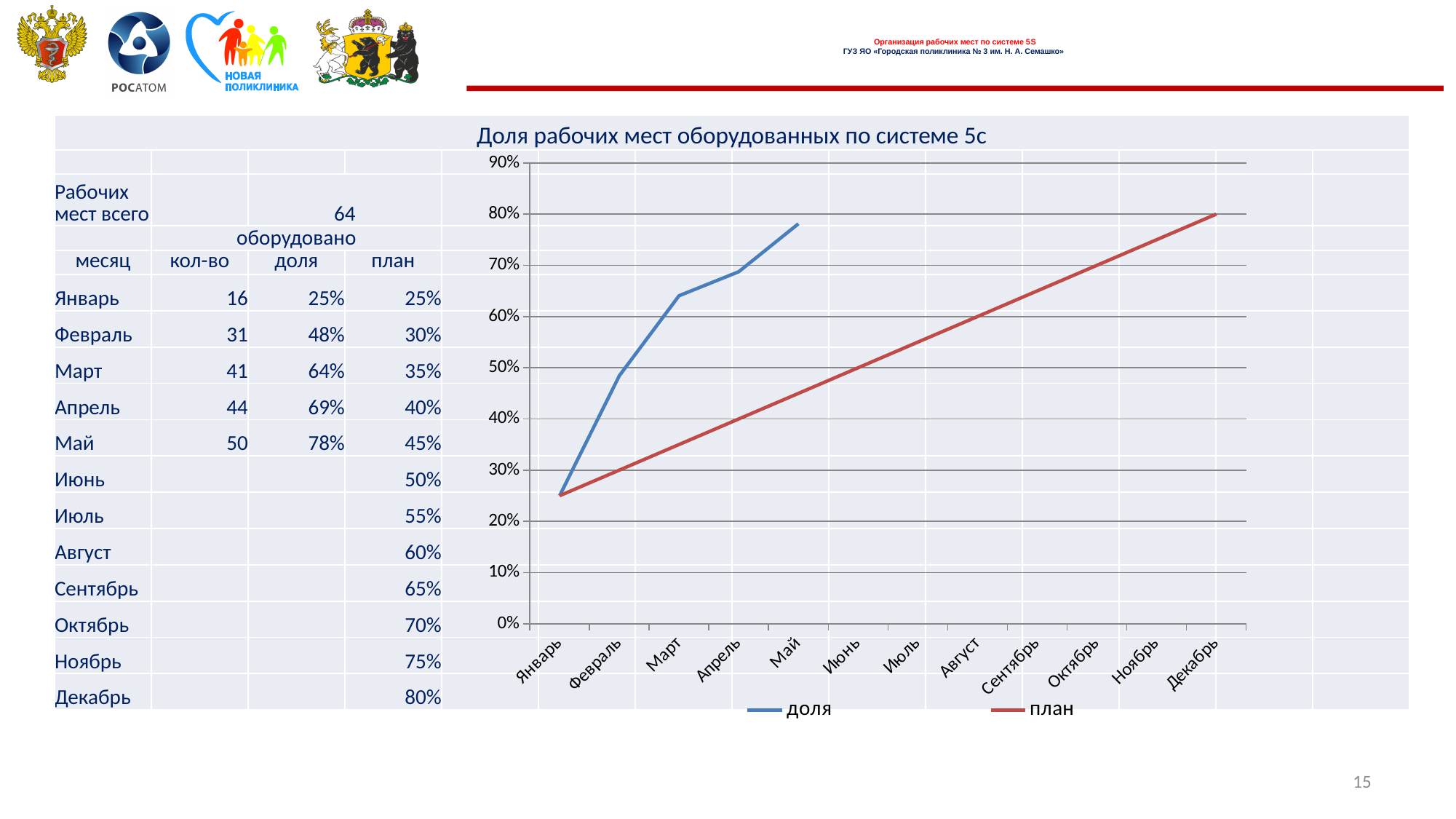
Which month has the highest value in the доля series? Май How many months are shown along the x axis of the chart? 12 How many series does the chart legend list? 2 Which is larger for Февраль, the доля value or the план value? доля What is the difference between the доля value and the план value for Апрель? 29% What is the value of the доля series for Март? 64% What is the value of the доля series for Май? 78% What are the names of the two series in the chart legend? доля and план What kind of chart is shown on the slide? line chart Does the доля series rise or fall from Январь to Май? rise What is the title of the chart? Доля рабочих мест оборудованных по системе 5с What is the value of the план series for Декабрь? 80%